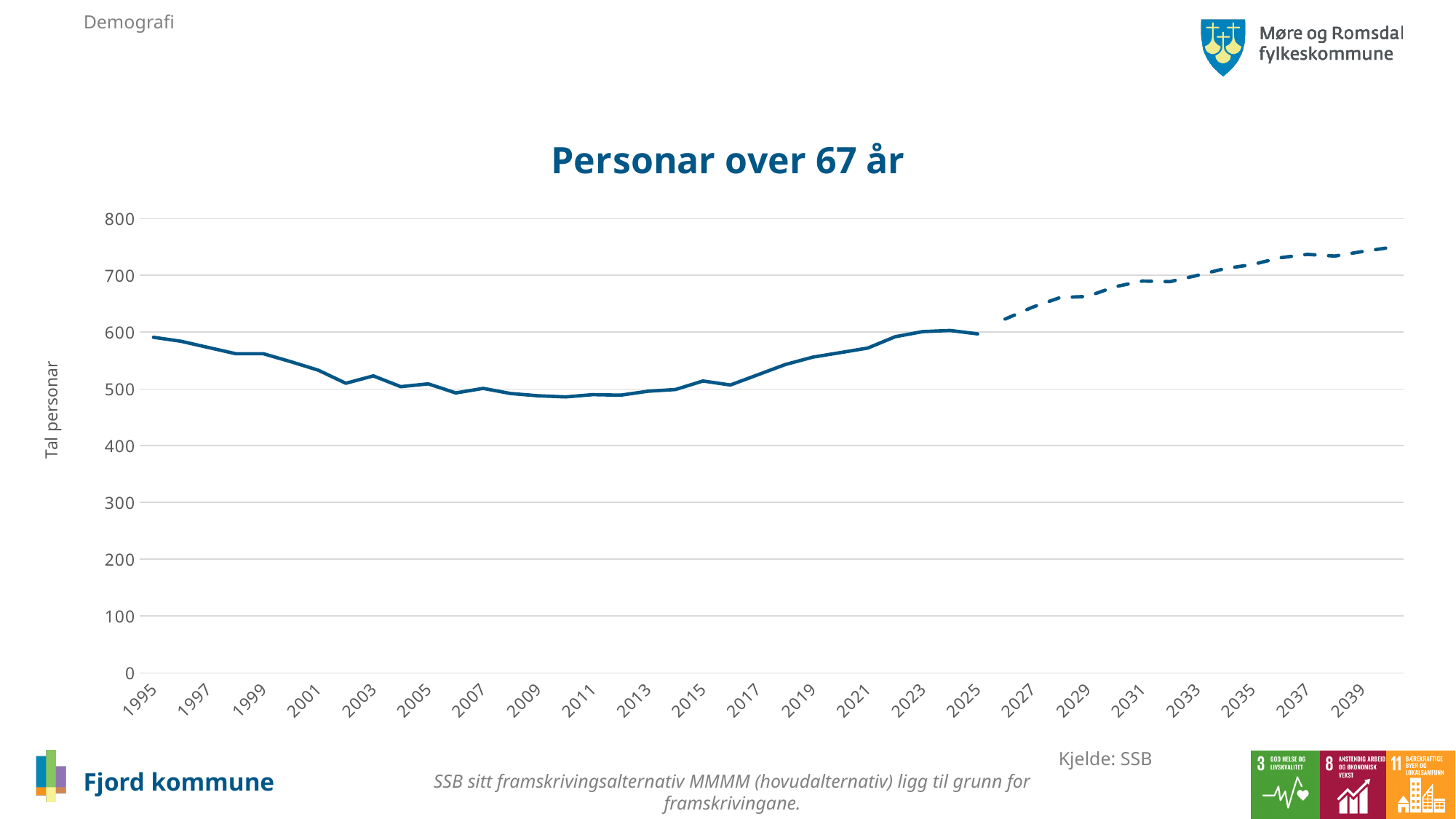
Is the value for 2019 greater or less than 500? greater What is the label on the vertical axis of the chart? Tal personar Is the value for 2009 greater or less than 500? less Do the values rise or fall along the dashed part of the line from 2027 to 2039? rise What is the title of the chart? Personar over 67 år Is the value for 1995 greater or less than 500? greater What kind of chart is shown on the slide? line chart Do the values rise or fall from 1995 to 2009? fall Which year has the larger value, 1995 or 2009? 1995